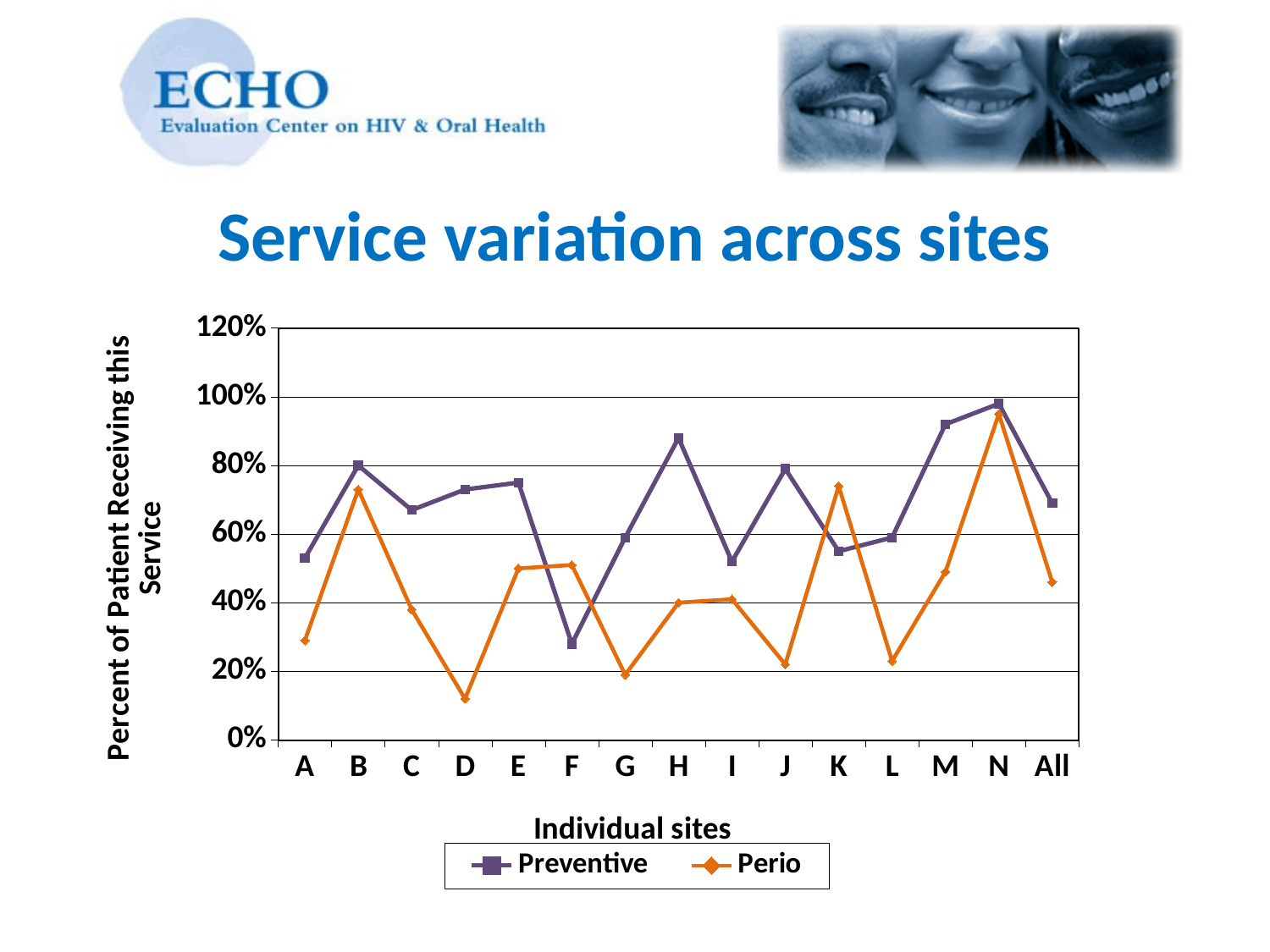
Is the Perio value for site D greater or less than 20%? less Which site has the lowest Preventive value? F Which site has the lowest Perio value? D How many series does the legend list? 2 Which site has the highest Preventive value? N What kind of chart is shown on the slide? line chart At site A, which series has the larger value, Preventive or Perio? Preventive How many categories are shown on the x axis? 15 At site F, which series has the larger value, Preventive or Perio? Perio Is the Preventive value for site F greater or less than 40%? less Is the Preventive value for site N greater or less than 80%? greater What is the label of the y axis? Percent of Patient Receiving this Service